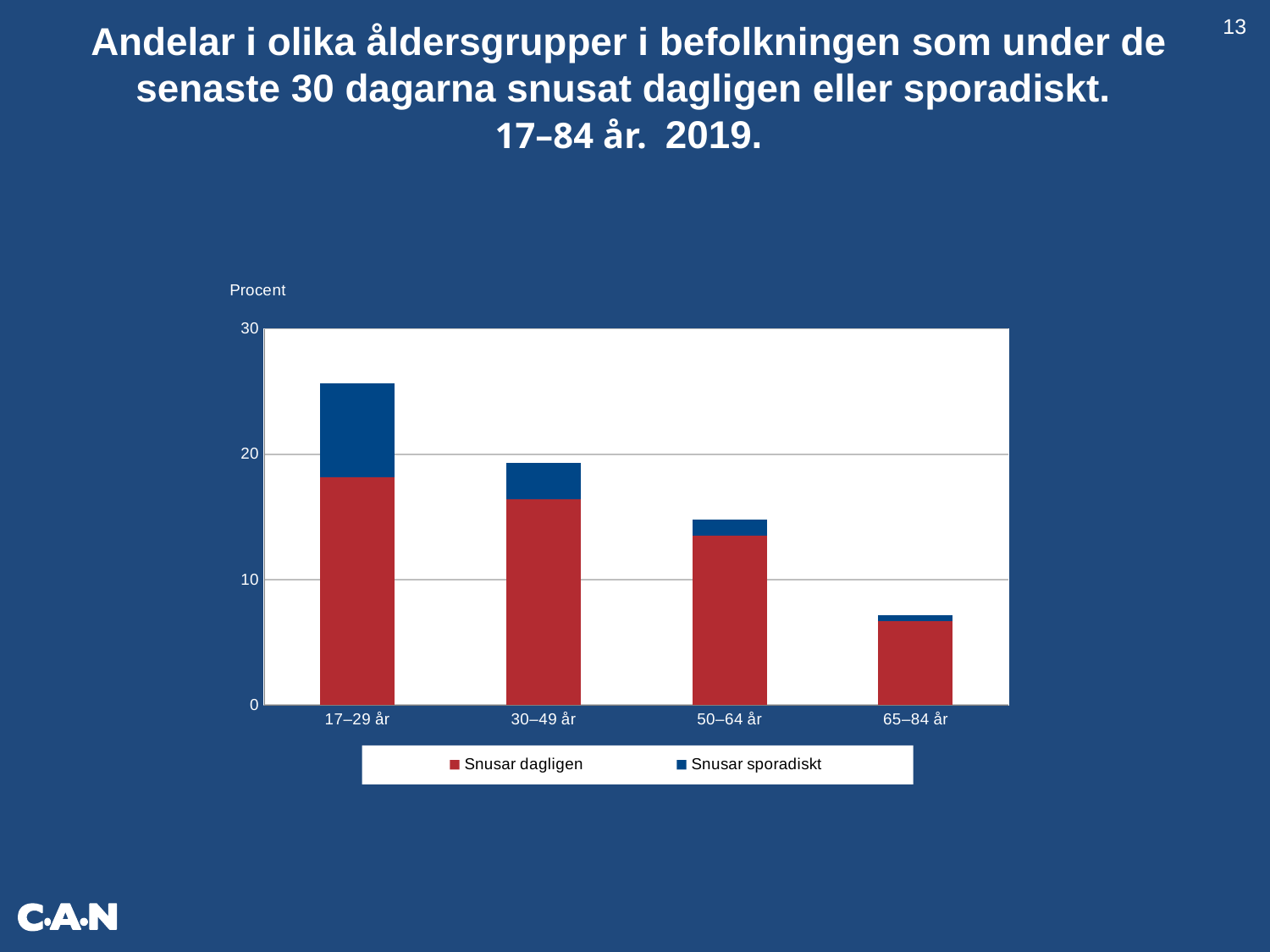
Is the 'Snusar dagligen' value for 50–64 år greater or less than 10? greater Do the total bar heights rise or fall as age increases along the x axis? fall Which age group has the lowest total share of snus users? 65–84 år Which series is shown in red in the legend? Snusar dagligen Which age group has the highest total share of snus users? 17–29 år Is the 'Snusar dagligen' value for 17–29 år greater or less than 20? less What kind of chart is shown on the slide? Stacked bar chart Is the total bar for 17–29 år greater or less than 20? greater Which is larger, the 'Snusar sporadiskt' segment for 17–29 år or for 30–49 år? 17–29 år How many series does the legend list? 2 How many age groups are shown on the x axis? 4